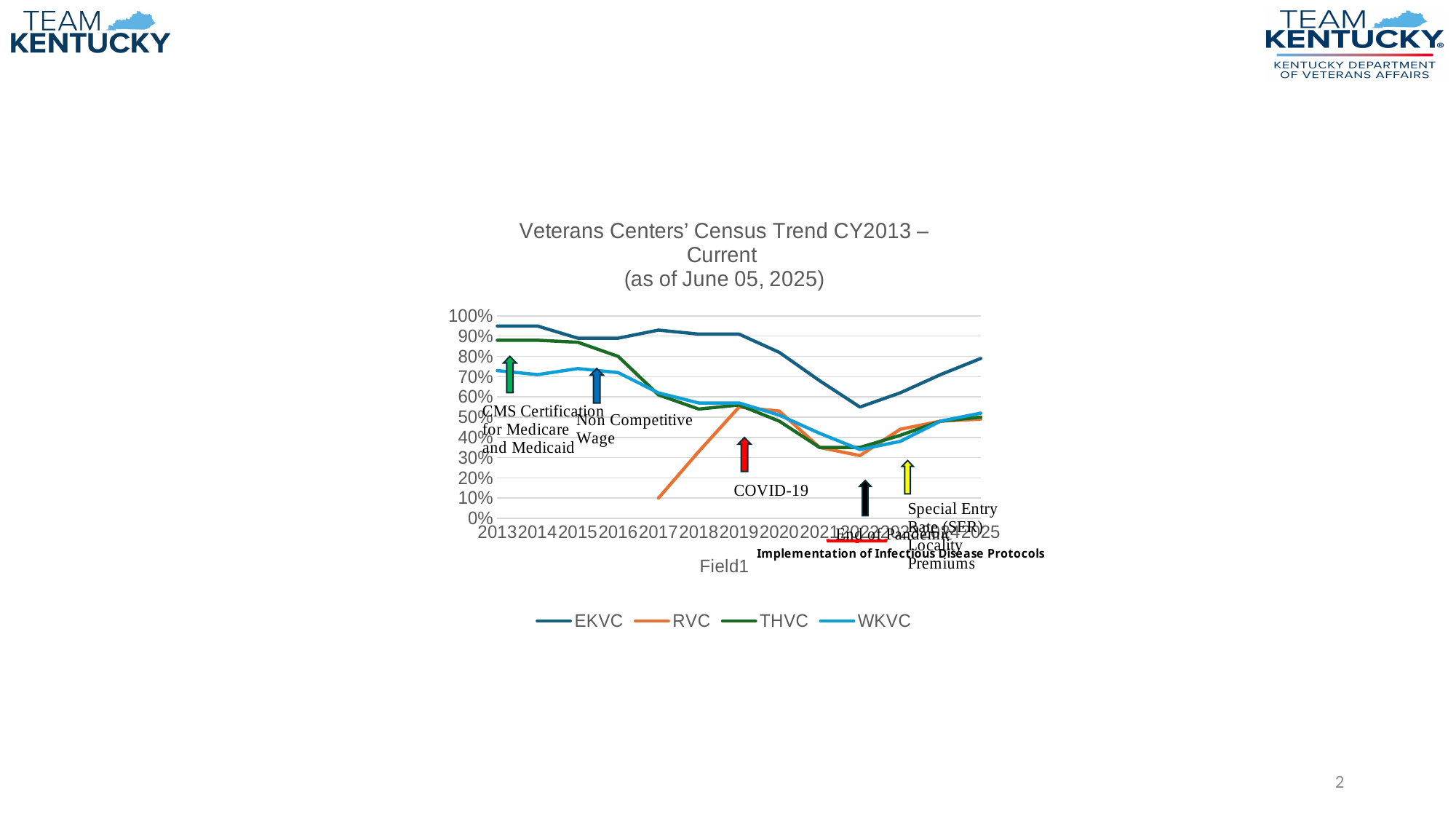
Is the value for THVC in 2021 greater or less than 40%? less Which series has the highest value in 2022? EKVC Which is larger in 2015, the value for EKVC or the value for WKVC? EKVC Which series has the highest value in 2013? EKVC Is the value for EKVC in 2025 greater or less than 70%? greater Is the value for EKVC in 2013 greater or less than 90%? greater How many series does the legend list? 4 What is the title of the chart? Veterans Centers' Census Trend CY2013 – Current (as of June 05, 2025) Does the EKVC line rise or fall from 2019 to 2022? Fall What kind of chart is shown on the slide? Line chart What label is shown on the x axis of the chart? Field1